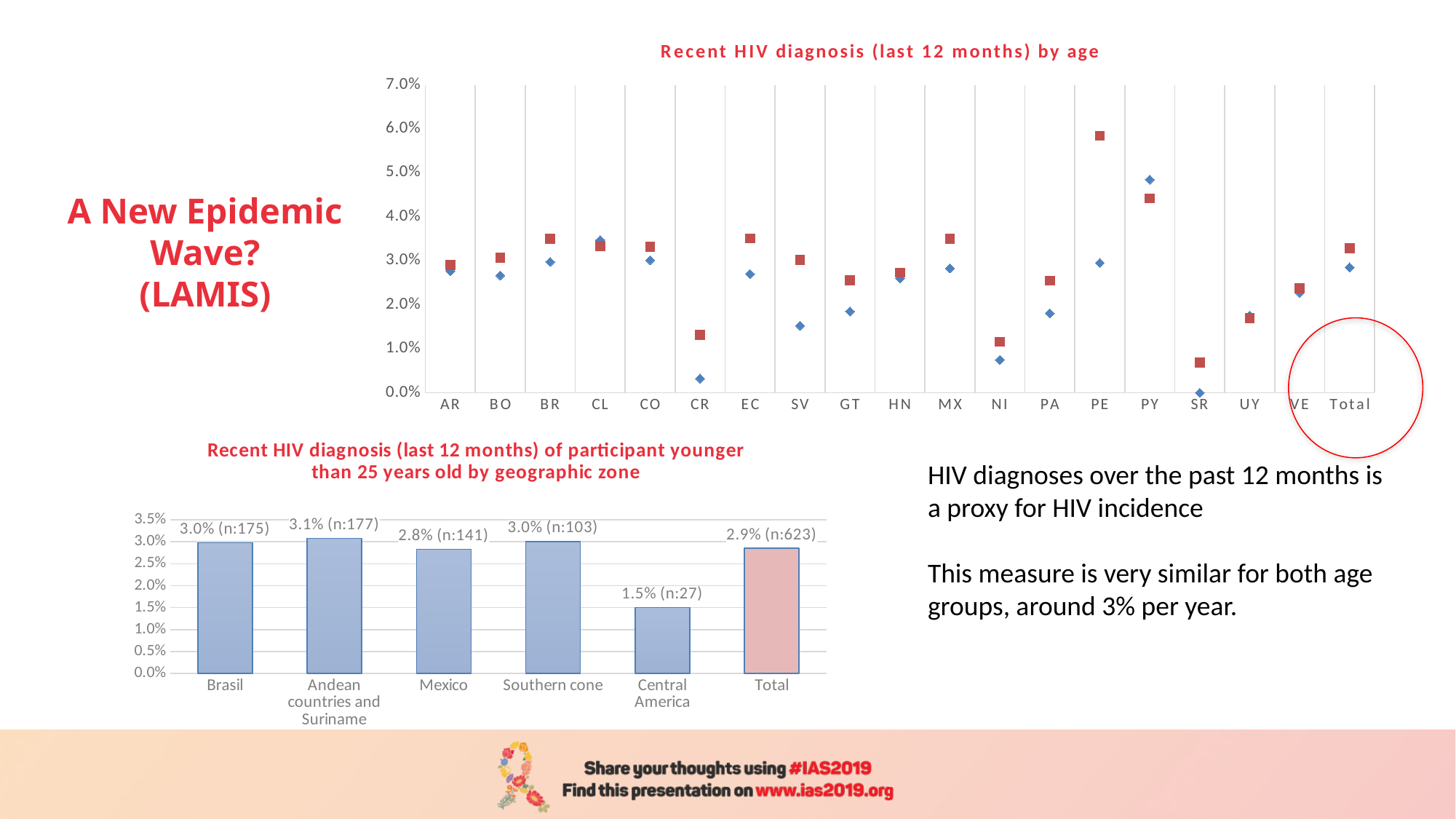
In the bottom chart, which geographic zone has the highest value? Andean countries and Suriname In the bottom chart, which is larger, the value for Brasil or the value for Mexico? Brasil In the bottom chart, what is the value for Total? 2.9% (n:623) In the bottom chart, which geographic zone has the lowest value? Central America In the top chart 'Recent HIV diagnosis (last 12 months) by age', is the red square marker for PE greater or less than 5.0%? greater In the top chart 'Recent HIV diagnosis (last 12 months) by age', is the blue diamond marker for CR greater or less than 1.0%? less In the bottom chart, how many bars are plotted? 6 In the bottom chart, what is the difference in percentage between Andean countries and Suriname and Central America? 1.6% What kind of chart is the bottom chart? Bar chart In the top chart 'Recent HIV diagnosis (last 12 months) by age', how many categories are shown on the x axis? 19 In the bottom chart, what is the value for Central America? 1.5% (n:27) In the bottom chart, what is the value for Mexico? 2.8% (n:141)